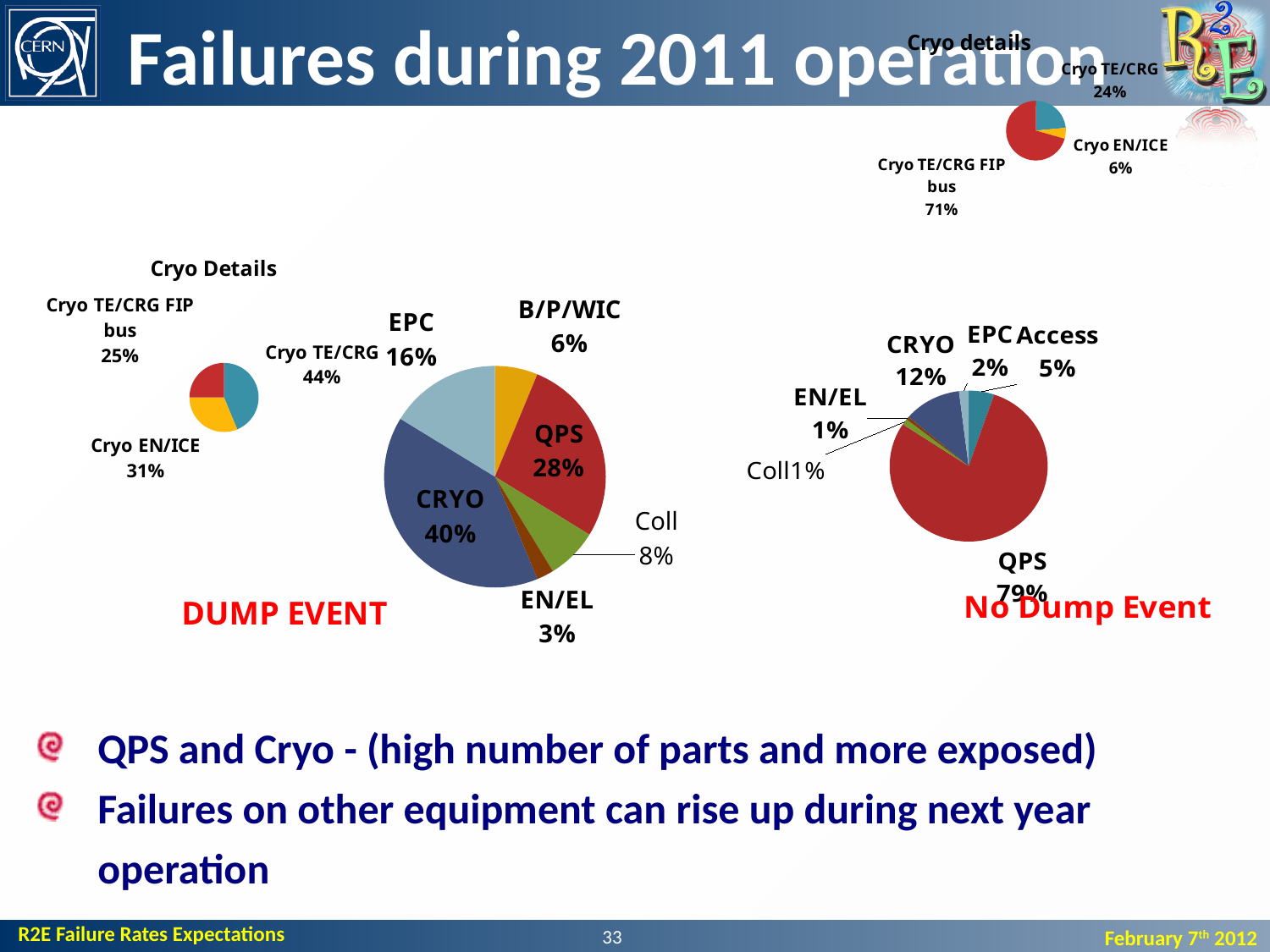
In the DUMP EVENT pie chart, how many categories are shown? 6 In the DUMP EVENT pie chart, what share does CRYO have? 40% In the No Dump Event pie chart, what share does CRYO have? 12% In the Cryo details pie chart at the top right of the slide, what share does Cryo TE/CRG FIP bus have? 71% In the DUMP EVENT pie chart, which category has the smallest share? EN/EL In the Cryo Details pie chart on the left of the slide, what share does Cryo TE/CRG have? 44% In the DUMP EVENT pie chart, what share does QPS have? 28% In the DUMP EVENT pie chart, what is the difference between the CRYO share and the QPS share? 12% In the No Dump Event pie chart, what share does QPS have? 79% What kind of chart is the DUMP EVENT chart? Pie chart In the DUMP EVENT pie chart, which category has the largest share? CRYO In the No Dump Event pie chart, which is larger, the Access share or the EPC share? Access